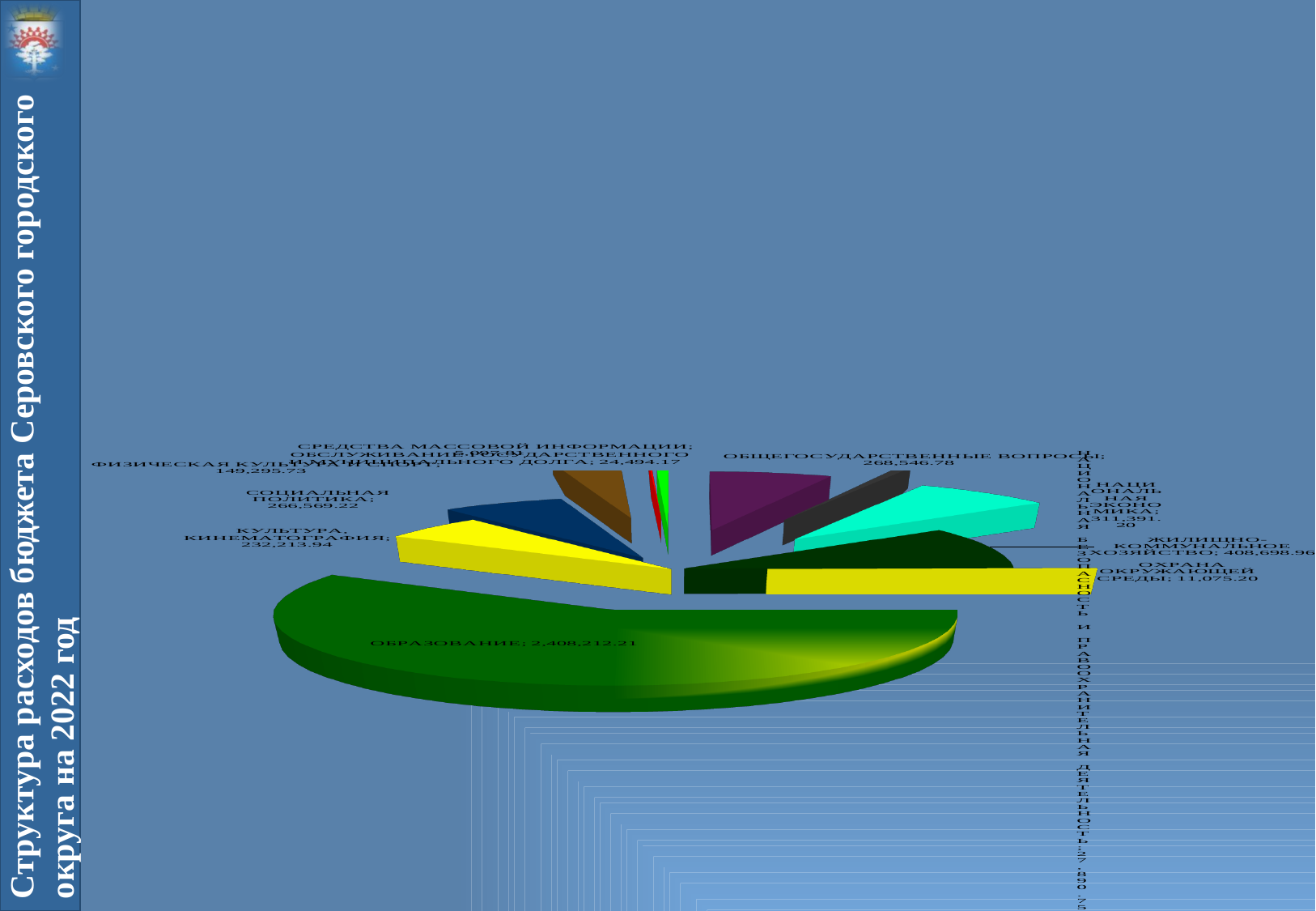
What is the value for ОБСЛУЖИВАНИЕ ГОСУДАРСТВЕННОГО И МУНИЦИПАЛЬНОГО ДОЛГА? 24,494.17 What is the value for ЖИЛИЩНО-КОММУНАЛЬНОЕ ХОЗЯЙСТВО? 408,698.96 Which is larger, СОЦИАЛЬНАЯ ПОЛИТИКА or КУЛЬТУРА, КИНЕМАТОГРАФИЯ? СОЦИАЛЬНАЯ ПОЛИТИКА What is the title of the slide containing the chart? Структура расходов бюджета Серовского городского округа на 2022 год What is the value for КУЛЬТУРА, КИНЕМАТОГРАФИЯ? 232,213.94 What is the value for ОБЩЕГОСУДАРСТВЕННЫЕ ВОПРОСЫ? 268,546.78 What is the value for ОБРАЗОВАНИЕ? 2,408,212.21 What is the value for ОХРАНА ОКРУЖАЮЩЕЙ СРЕДЫ? 11,075.20 Which category has the largest slice of the pie? ОБРАЗОВАНИЕ What is the difference between ОБЩЕГОСУДАРСТВЕННЫЕ ВОПРОСЫ and СОЦИАЛЬНАЯ ПОЛИТИКА? 1,977.56 What is the value for СОЦИАЛЬНАЯ ПОЛИТИКА? 266,569.22 What kind of chart is shown on the slide? pie chart